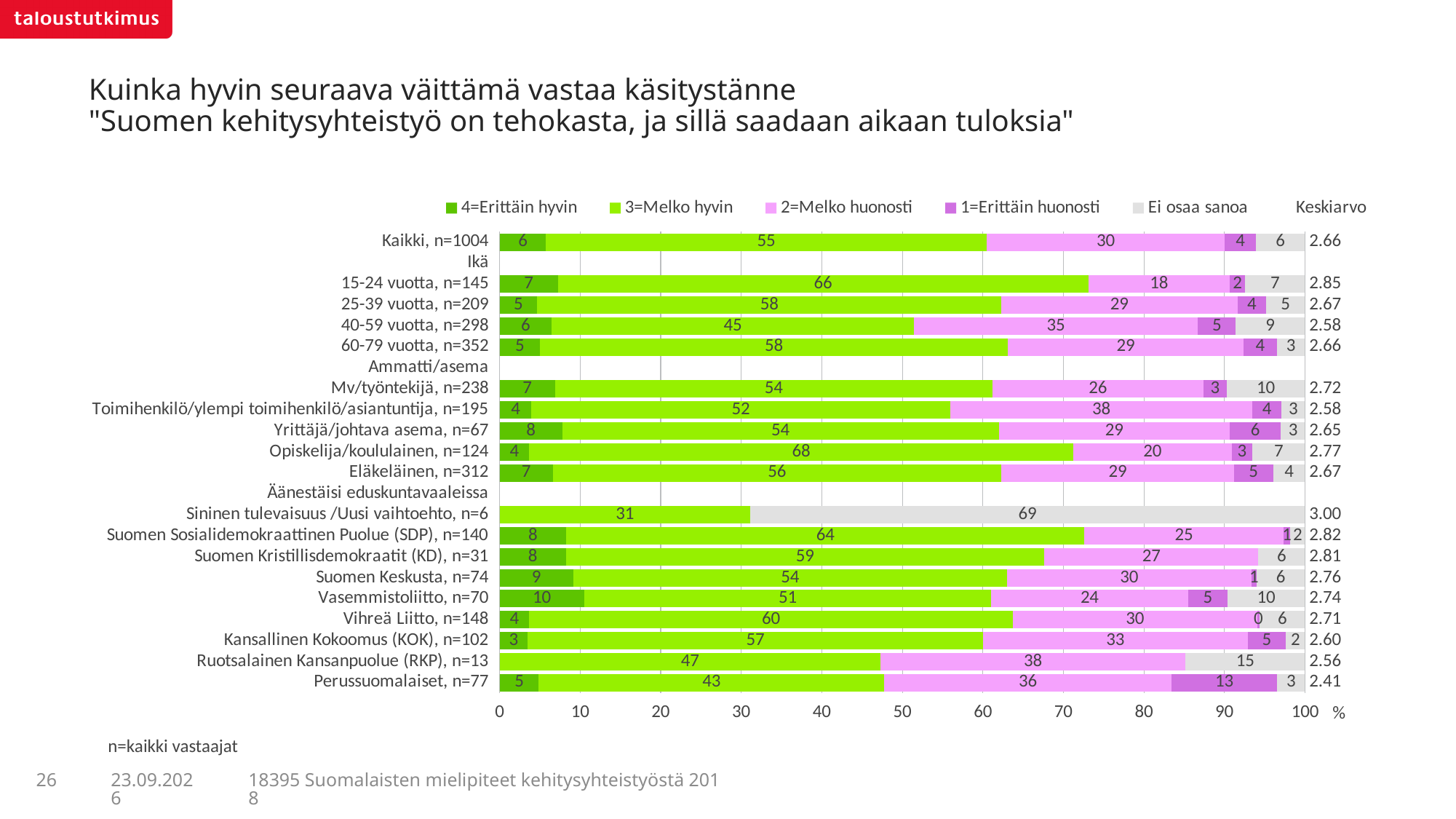
Which category has the lowest Keskiarvo? Perussuomalaiset, n=77 What is the difference between the 3=Melko hyvin values for 15-24 vuotta, n=145 and 40-59 vuotta, n=298? 21 What is the Keskiarvo for Sininen tulevaisuus /Uusi vaihtoehto, n=6? 3.00 Is the Ei osaa sanoa value for Sininen tulevaisuus /Uusi vaihtoehto, n=6 greater or less than 50? greater Which has a larger 3=Melko hyvin value, Vihreä Liitto, n=148 or Kansallinen Kokoomus (KOK), n=102? Vihreä Liitto, n=148 Which category has the highest value for 4=Erittäin hyvin? Vasemmistoliitto, n=70 What is the value of 1=Erittäin huonosti for Perussuomalaiset, n=77? 13 What kind of chart is shown on the slide? bar chart What is the value of 3=Melko hyvin for 15-24 vuotta, n=145? 66 What is the value of 3=Melko hyvin for Kaikki, n=1004? 55 Which category has the highest value for Ei osaa sanoa? Sininen tulevaisuus /Uusi vaihtoehto, n=6 What is the total of the stacked bar for Perussuomalaiset, n=77? 100